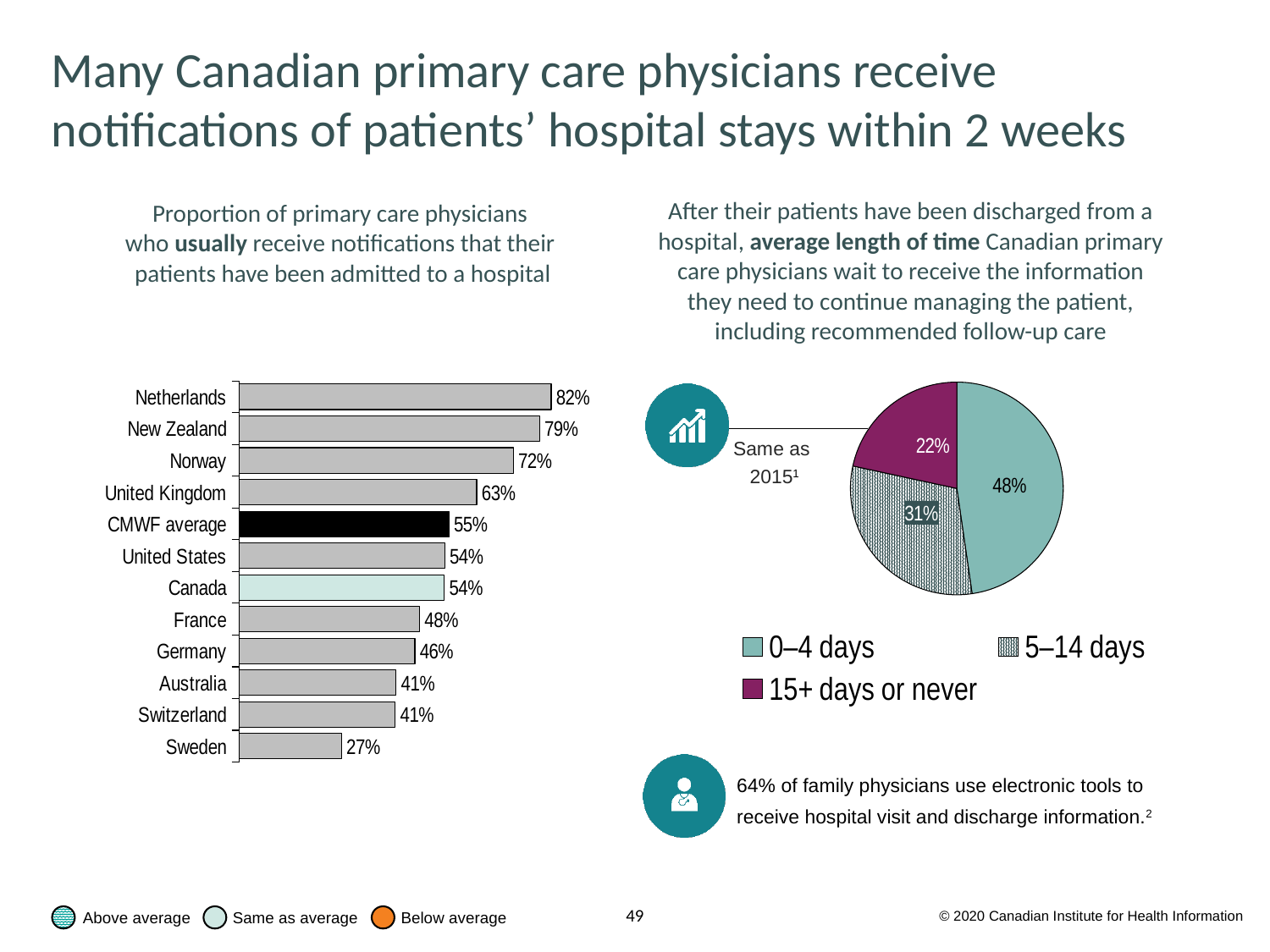
In the bar chart on the left, which country has the highest value? Netherlands In the bar chart on the left, what is the CMWF average? 55% In the pie chart on the right, which category has the largest share? 0–4 days How many categories does the legend of the pie chart on the right list? 3 In the bar chart on the left, which country has the lowest value? Sweden In the bar chart on the left, what is the difference between the Netherlands and Sweden? 55% In the bar chart on the left, what is the value for Canada? 54% In the pie chart on the right, what share is 5–14 days? 31% In the bar chart on the left, what is the value for the Netherlands? 82% In the bar chart on the left, which is larger, the value for Norway or the value for France? Norway How many bars are shown in the bar chart on the left? 12 What kind of chart is on the left side of the slide? Bar chart